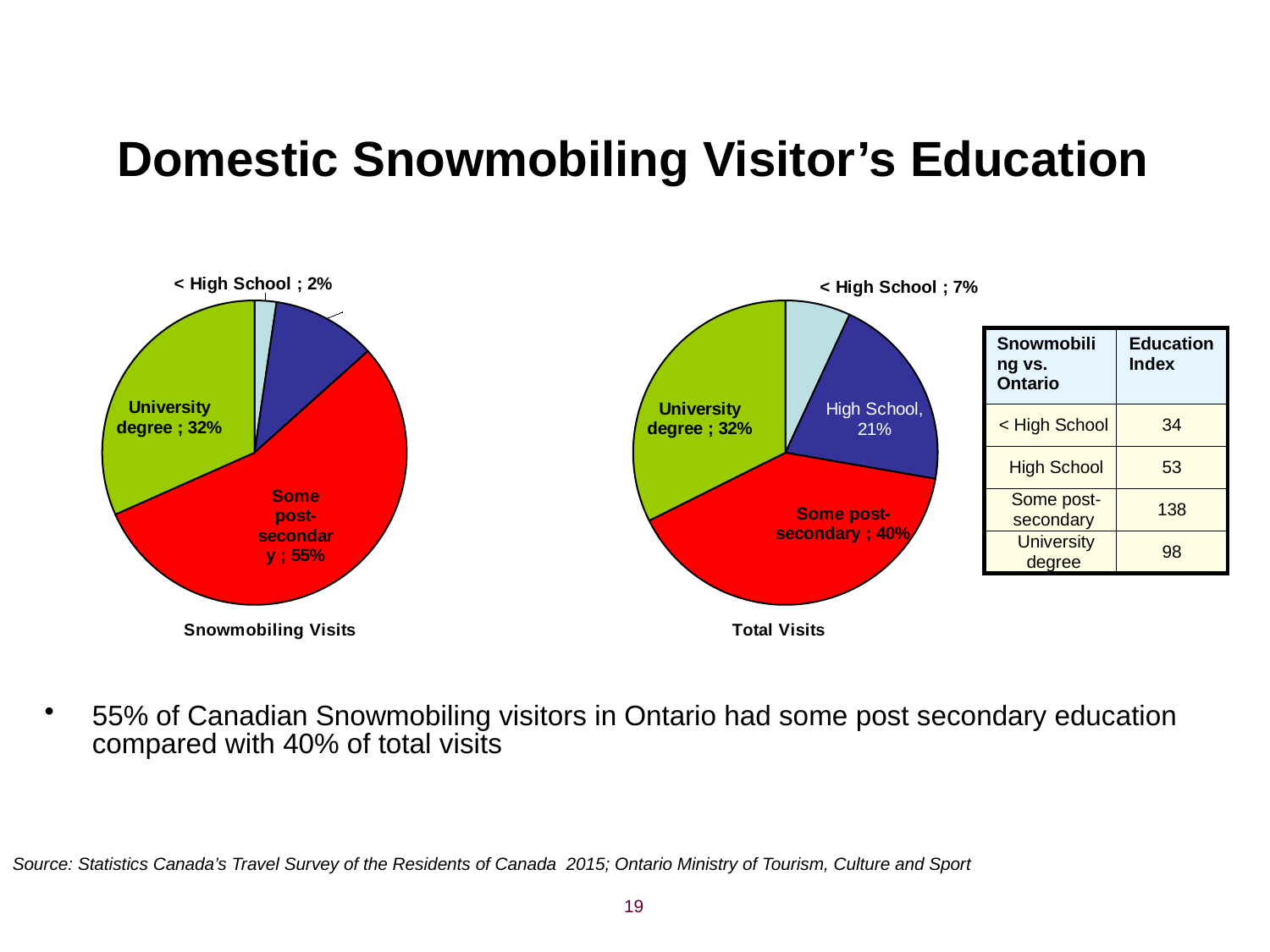
In the Snowmobiling Visits pie chart, what share of visits is for Some post-secondary education? 55% In the Total Visits pie chart, which education category has the smallest slice? < High School How many slices does the Total Visits pie chart have? 4 What is the difference between the Some post-secondary share in the Snowmobiling Visits pie chart and the Some post-secondary share in the Total Visits pie chart? 15% In the Total Visits pie chart, what share of visits is for < High School? 7% In the Snowmobiling Visits pie chart, what share of visits is for University degree? 32% In the Snowmobiling Visits pie chart, which education category has the smallest slice? < High School What colour is the Some post-secondary slice in the Total Visits pie chart? Red In the Total Visits pie chart, which education category has the largest slice? Some post-secondary In the Total Visits pie chart, what share of visits is for High School? 21% What type of chart is used for Snowmobiling Visits? Pie chart Which is larger: the < High School share in the Snowmobiling Visits pie chart or the < High School share in the Total Visits pie chart? Total Visits